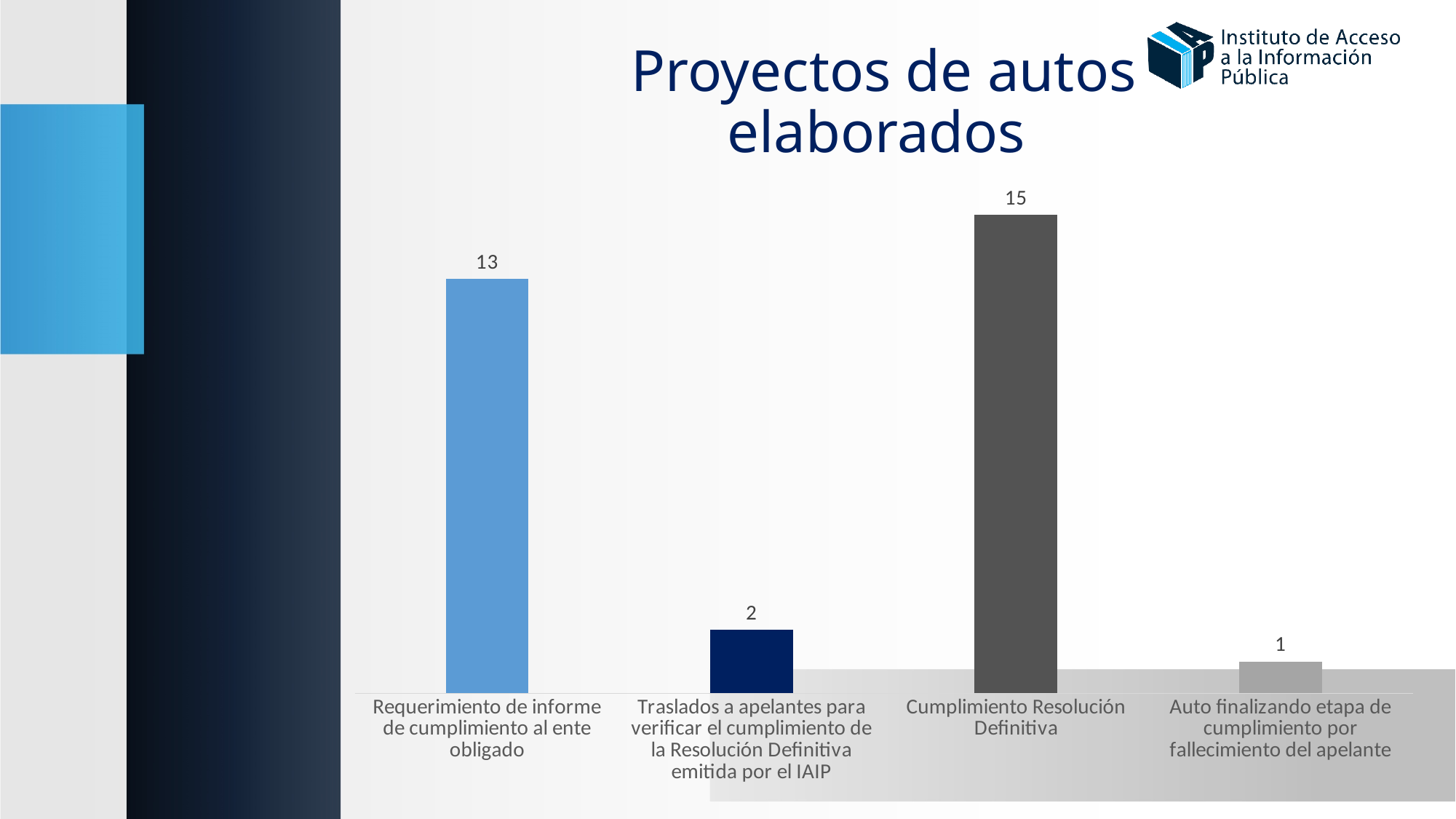
What is the value for "Traslados a apelantes para verificar el cumplimiento de la Resolución Definitiva emitida por el IAIP"? 2 Which category has the lowest value? Auto finalizando etapa de cumplimiento por fallecimiento del apelante What is the value for "Cumplimiento Resolución Definitiva"? 15 What kind of chart is shown on the slide? Bar chart What is the difference between the values for "Cumplimiento Resolución Definitiva" and "Requerimiento de informe de cumplimiento al ente obligado"? 2 What is the value for "Auto finalizando etapa de cumplimiento por fallecimiento del apelante"? 1 Which is larger: the value for "Traslados a apelantes para verificar el cumplimiento de la Resolución Definitiva emitida por el IAIP" or the value for "Auto finalizando etapa de cumplimiento por fallecimiento del apelante"? Traslados a apelantes para verificar el cumplimiento de la Resolución Definitiva emitida por el IAIP Which category has the highest value? Cumplimiento Resolución Definitiva How many categories are shown in the chart? 4 What is the title of the chart? Proyectos de autos elaborados What colour is the bar for "Requerimiento de informe de cumplimiento al ente obligado"? Light blue What is the value for "Requerimiento de informe de cumplimiento al ente obligado"? 13